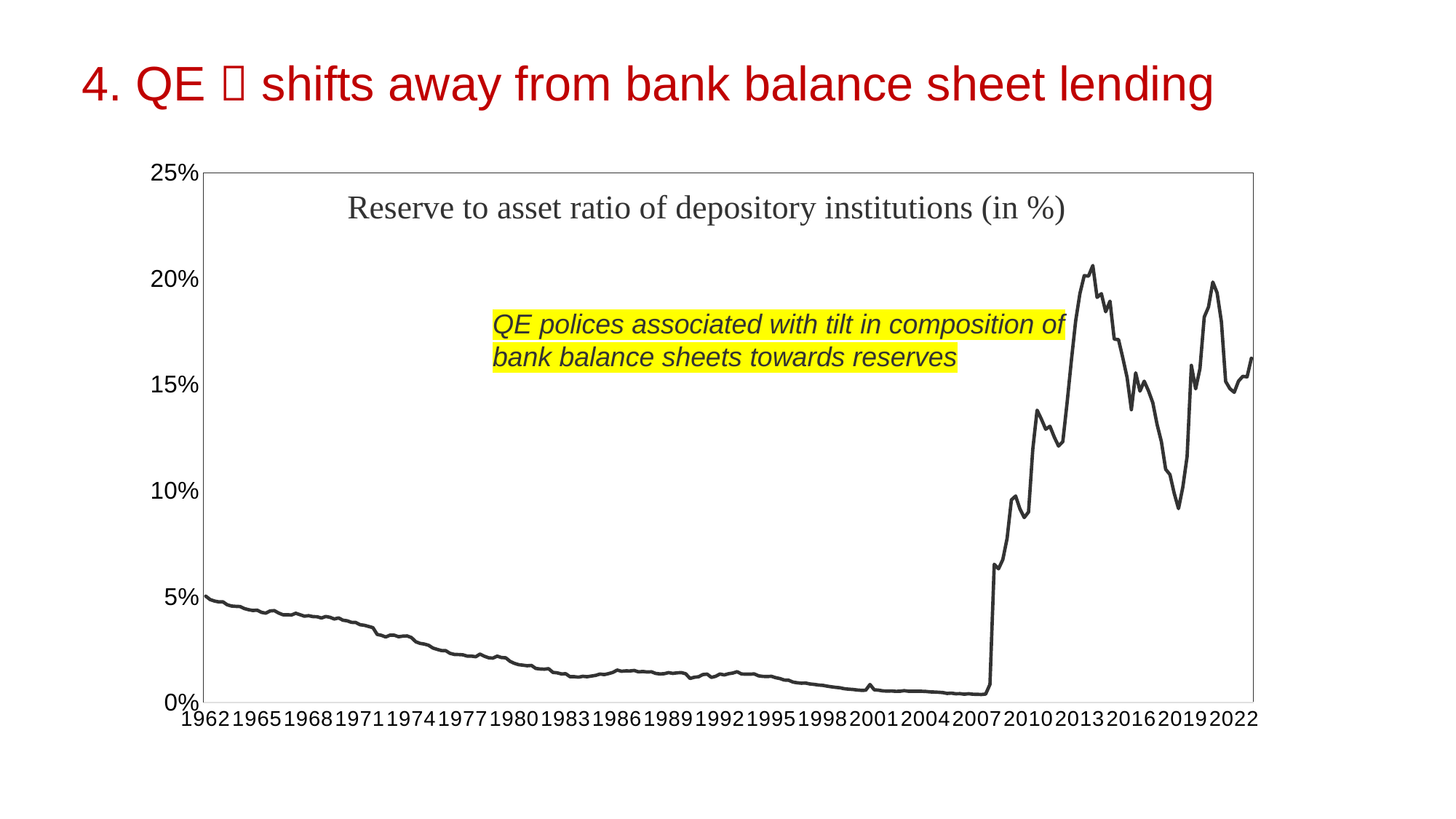
What kind of chart is shown on the slide? line chart Which is larger, the value for 1962 or the value for 2022? 2022 Which is larger, the value for 2001 or the value for 2010? 2010 Does the reserve to asset ratio rise or fall between 2007 and 2013? rise What is the title of the chart? Reserve to asset ratio of depository institutions (in %) Is the value for 1980 greater or less than 5%? less Is the value for 2019 greater or less than 5%? greater Does the reserve to asset ratio rise or fall between 1962 and 2007? fall What is the highest value shown on the vertical axis of the chart? 25% Is the value for 1962 greater or less than 10%? less